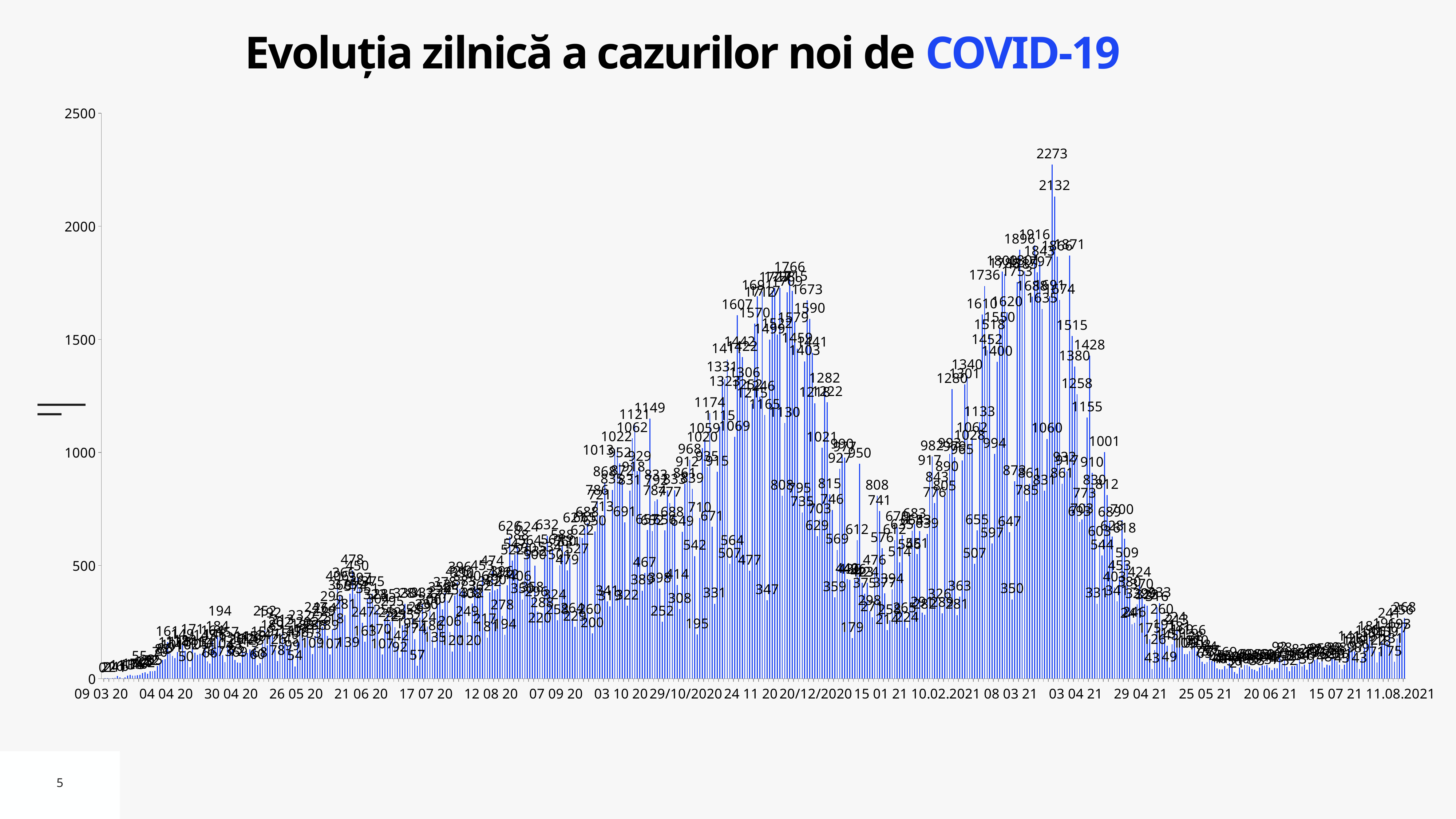
What is the maximum value shown on the vertical axis? 2500 What is the difference between the two highest labelled values, 2273 and 2132? 141 What is the highest labelled value in the first small wave around 21 06 20? 478 Do the values generally rise or fall between 03 04 21 and 25 05 21? fall What is the second-highest labelled value in the chart? 2132 What kind of chart is shown on the slide? bar chart Is the value at 11.08.2021 greater or less than 500? less Which is larger: the peak of the wave around 24 11 20 or the peak of the wave around 03 04 21? the peak around 03 04 21 What is the title of the chart? Evoluția zilnică a cazurilor noi de COVID-19 What is the value of the tallest bar in the chart? 2273 Is the peak value near 03 04 21 greater or less than 2000? greater What is the highest labelled value in the wave peaking around 24 11 20? 1766